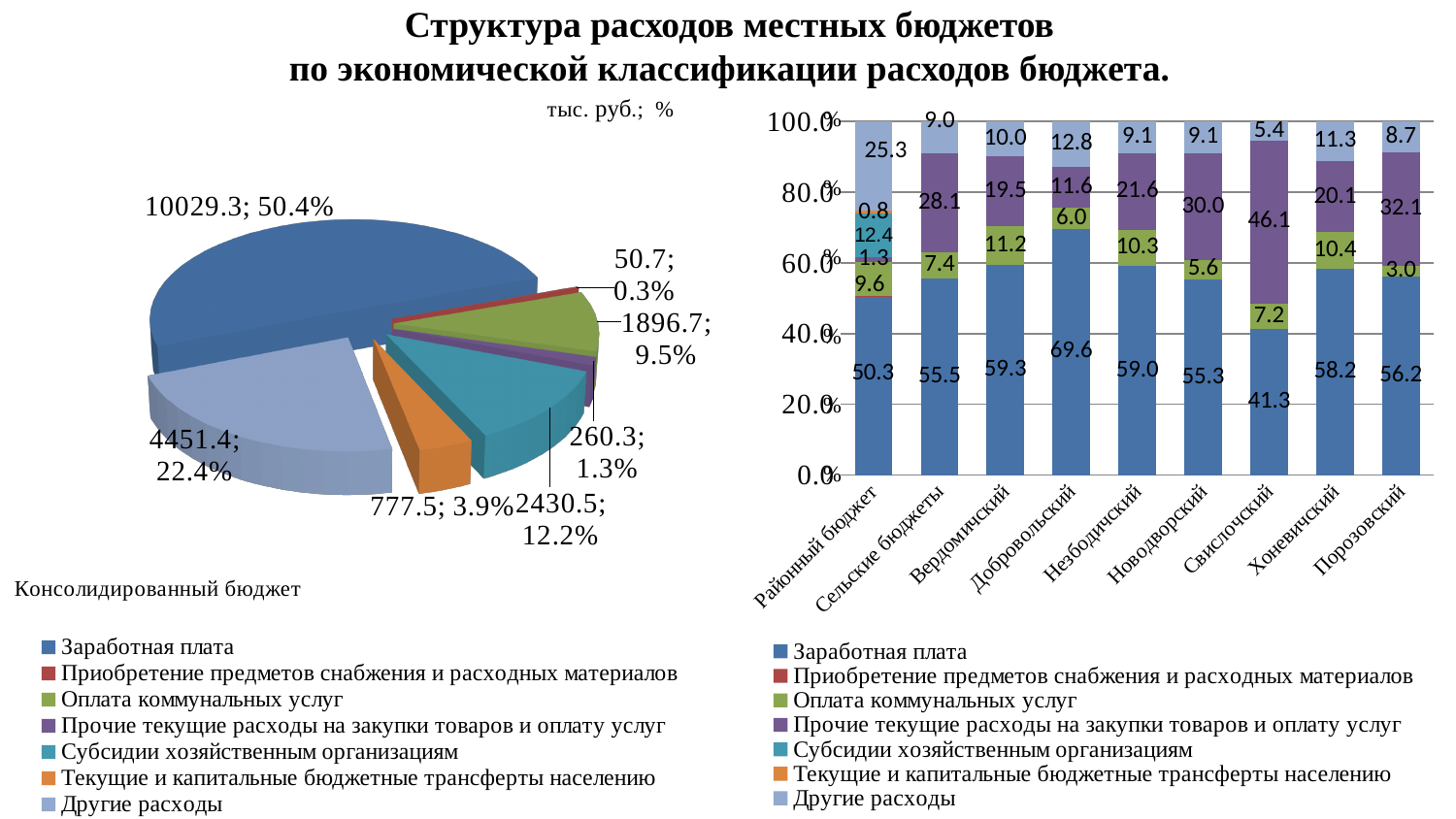
On the left-hand pie chart (Консолидированный бюджет), which slice is the smallest? Приобретение предметов снабжения и расходных материалов On the right-hand stacked bar chart, what is the value of Заработная плата for Добровольский? 69.6 What kind of chart is the right-hand chart on the slide? Stacked bar chart On the right-hand stacked bar chart, which is larger for Прочие текущие расходы на закупки товаров и оплату услуг: Свислочский or Новодворский? Свислочский On the right-hand stacked bar chart, what is the difference between the Заработная плата values for Добровольский and Свислочский? 28.3 How many categories are shown on the x axis of the right-hand stacked bar chart? 9 On the left-hand pie chart (Консолидированный бюджет), what value is shown for Другие расходы? 4451.4; 22.4% On the left-hand pie chart (Консолидированный бюджет), what share does Заработная плата have? 50.4% What label appears below the left-hand pie chart? Консолидированный бюджет How many series does the legend of the right-hand stacked bar chart list? 7 On the right-hand stacked bar chart, which category has the lowest value for Заработная плата? Свислочский On the right-hand stacked bar chart, which category has the highest value for Заработная плата? Добровольский